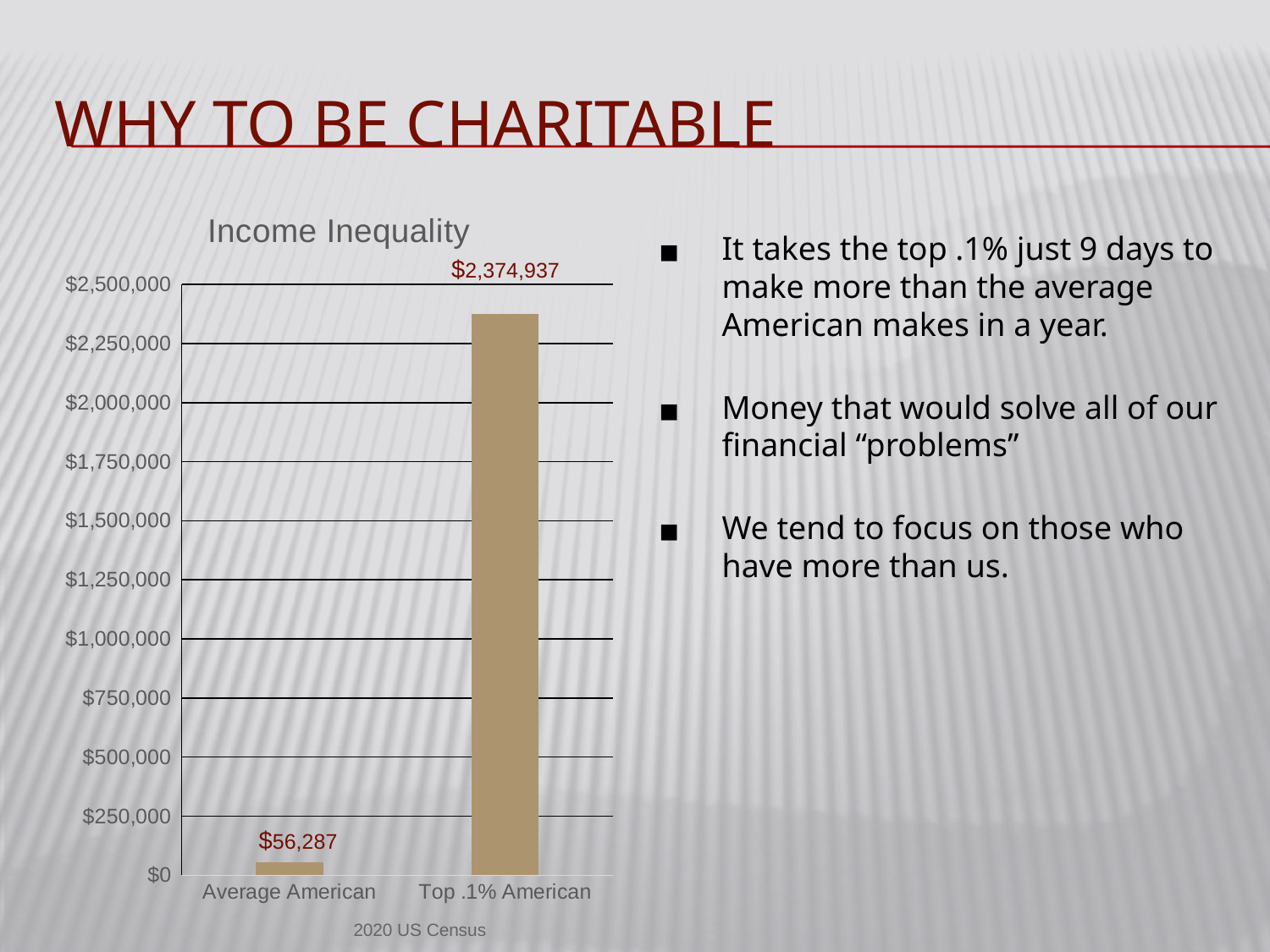
What is the value for Top .1% American in the Income Inequality chart? $2,374,937 What is the difference between the Top .1% American and Average American values in the Income Inequality chart? $2,318,650 What is the title of the chart on the slide? Income Inequality Is the value for Average American greater or less than $250,000? less What source is cited below the Income Inequality chart? 2020 US Census Which category has the highest value in the Income Inequality chart? Top .1% American Which category has the lowest value in the Income Inequality chart? Average American Is the value for Top .1% American greater or less than $2,250,000? greater How many categories are shown in the Income Inequality chart? 2 Which is larger in the Income Inequality chart: Average American or Top .1% American? Top .1% American What is the value for Average American in the Income Inequality chart? $56,287 What kind of chart is the Income Inequality chart? bar chart